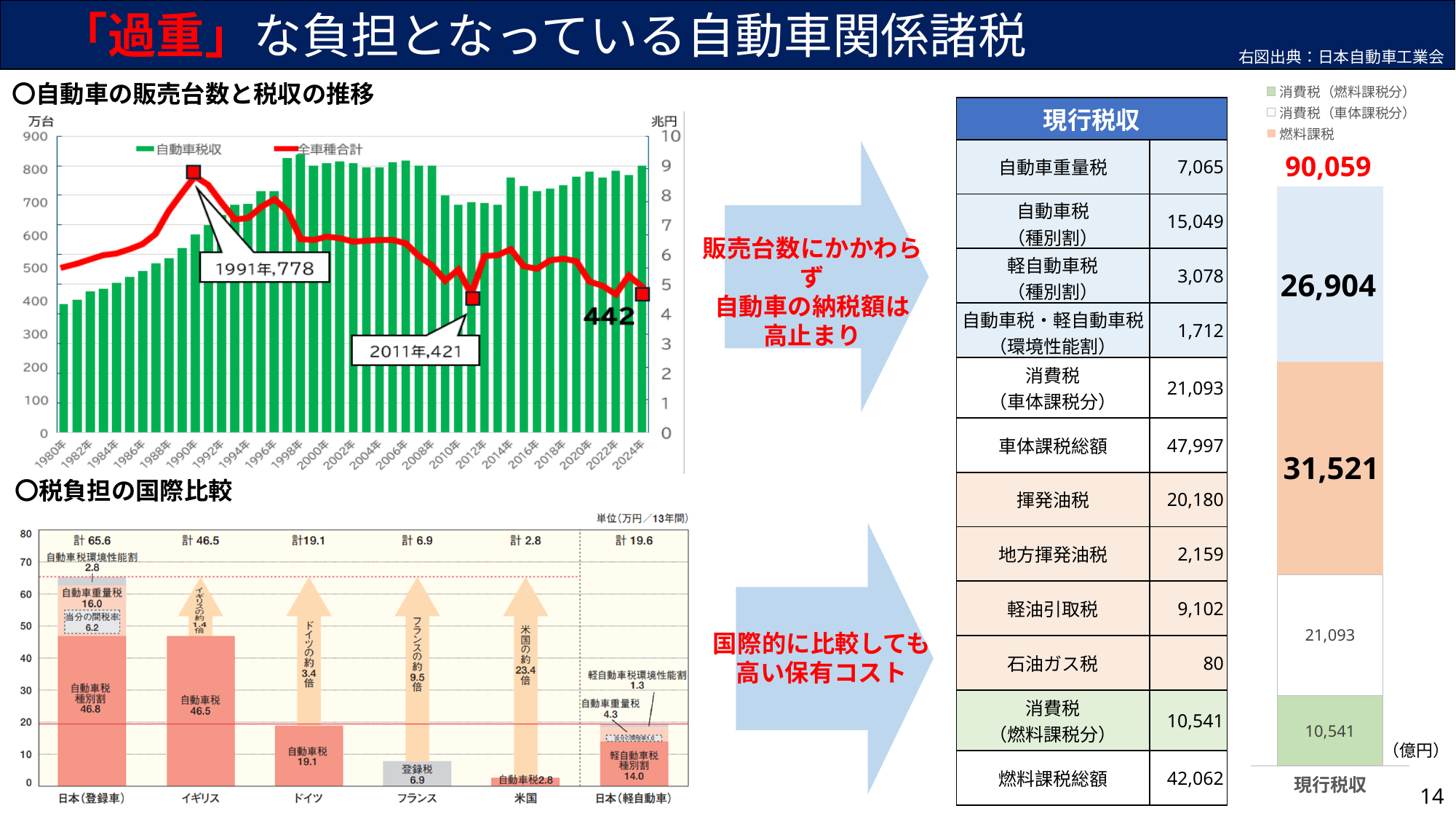
In the bottom-left chart (税負担の国際比較), how many countries/categories are shown on the x axis? 6 In the top-left chart (自動車の販売台数と税収の推移), does the 全車種合計 line rise or fall between 1991年 and 2011年? fall In the bottom-left chart (税負担の国際比較), what is the total (計) for イギリス? 46.5 In the top-left chart (自動車の販売台数と税収の推移), what value does the 全車種合計 line show for 2011年? 421 In the top-left chart (自動車の販売台数と税収の推移), what is the last labelled value of the 全車種合計 line at the right end? 442 In the top-left chart (自動車の販売台数と税収の推移), what value does the 全車種合計 line show for 1991年? 778 In the bottom-left chart (税負担の国際比較), which country has the highest total (計)? 日本（登録車） In the top-left chart (自動車の販売台数と税収の推移), how many series does the legend list? 2 In the right-hand stacked bar chart (現行税収), what is the total shown above the bar? 90,059 In the right-hand stacked bar chart (現行税収), which is larger, the 31,521 segment or the 26,904 segment? 31,521 In the bottom-left chart (税負担の国際比較), which country has the lowest total (計)? 米国 In the bottom-left chart (税負担の国際比較), what is the difference between the totals for 日本（登録車） and イギリス? 19.1